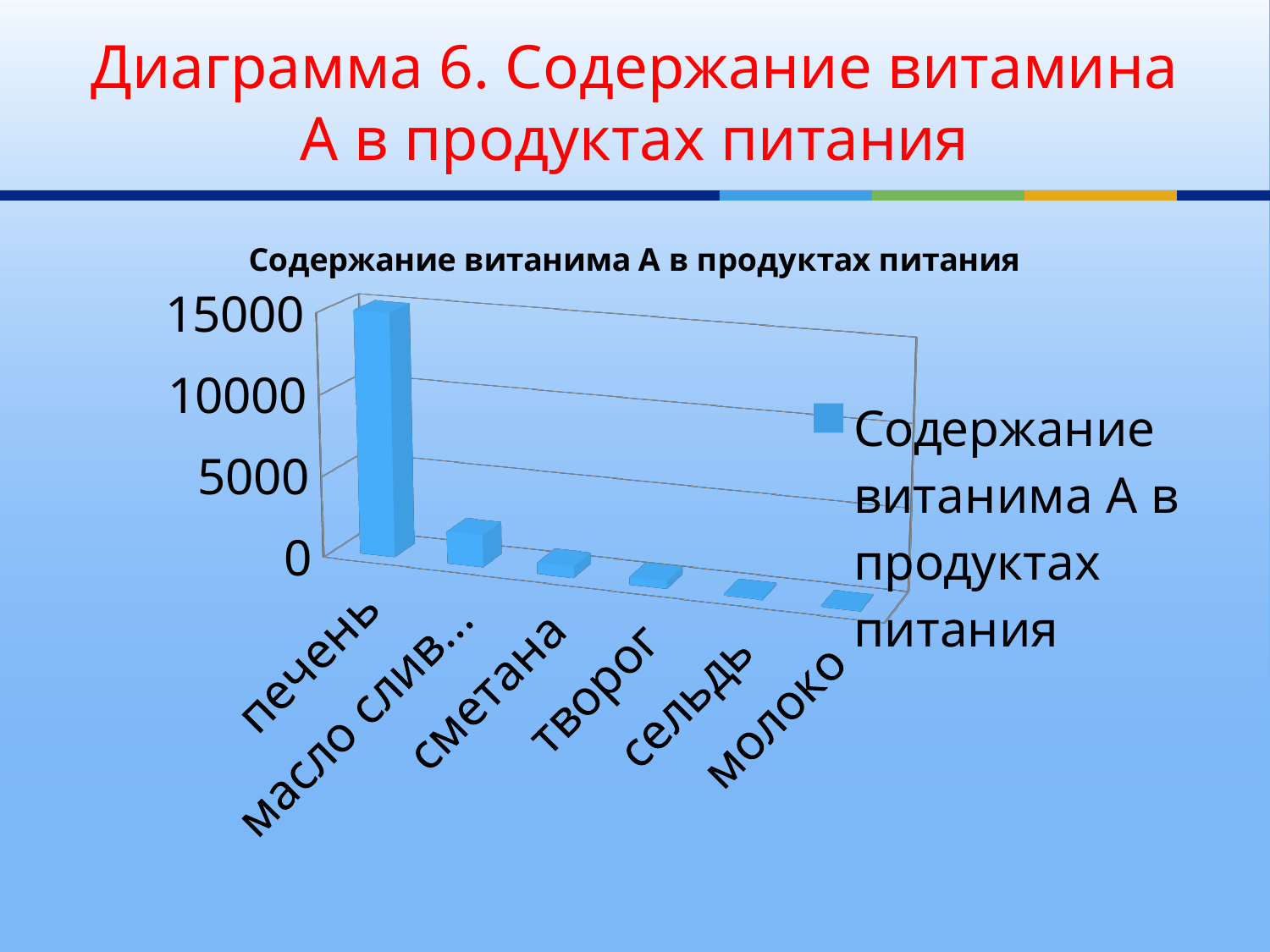
Is the value for молоко greater or less than 5000? less Do the values rise or fall moving from left to right along the x axis? fall What is the title of the chart? Содержание витанима А в продуктах питания How many product categories are shown on the x axis of the chart? 6 Which product has the highest vitamin A content in the chart? печень Which has a larger value, печень or масло слив...? печень Which has a larger value, масло слив... or сметана? масло слив... What kind of chart is shown on the slide? bar chart Is the value for печень greater or less than 10000? greater Is the value for сметана greater or less than 5000? less How many series does the chart legend list? 1